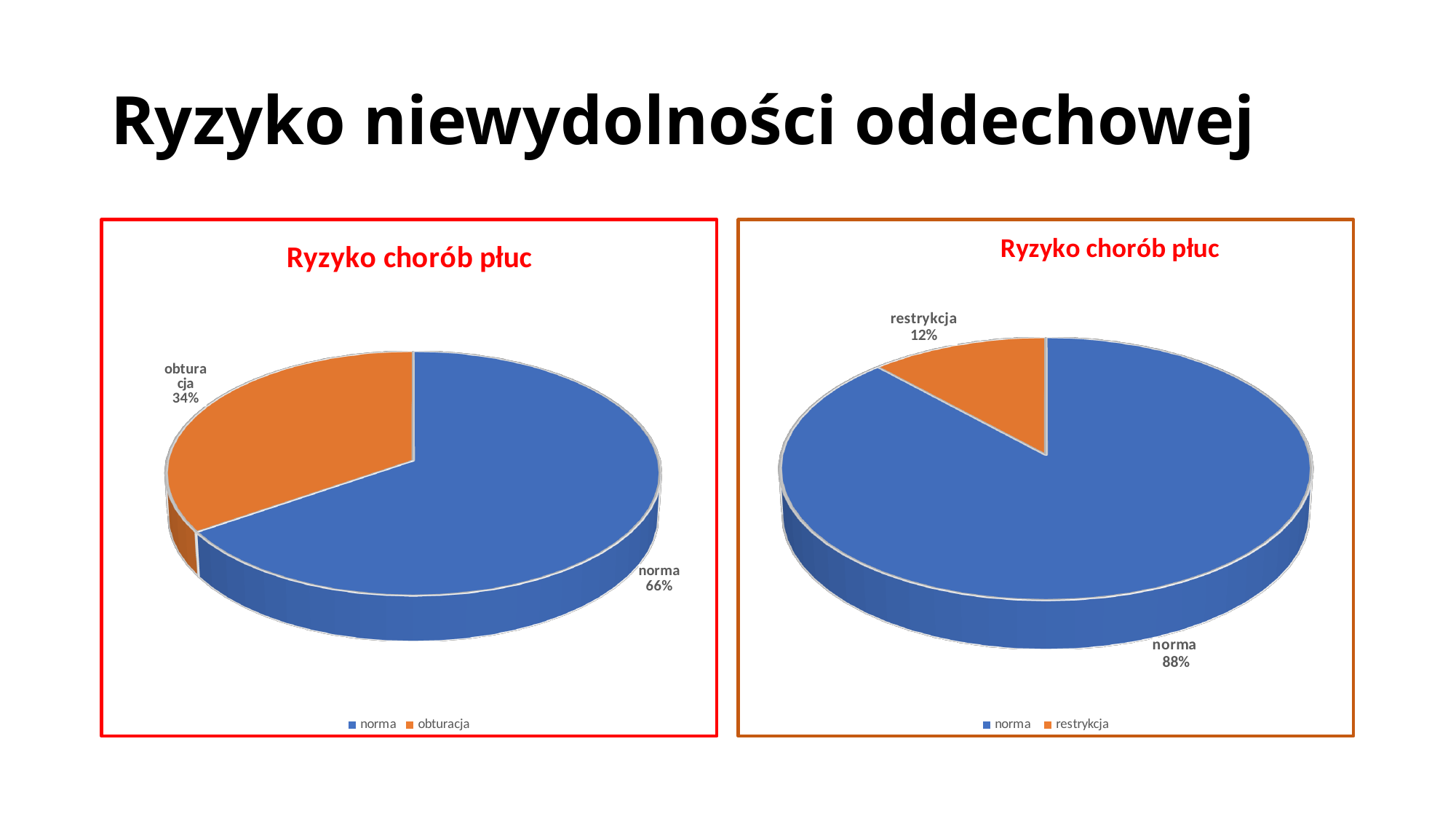
What entries does the legend of the right chart list? norma, restrykcja In the right pie chart, which slice is the smallest? restrykcja In the left pie chart, what share does the 'norma' slice have? 66% In the right pie chart, what is the difference in percentage points between 'norma' and 'restrykcja'? 76 In the right pie chart, what share does the 'norma' slice have? 88% In the left pie chart, what share does the 'obturacja' slice have? 34% In the left pie chart, which slice is the largest? norma What type of chart is shown on the right side of the slide? pie chart How many slices does the left pie chart have? 2 Which is larger: the 'norma' share in the left chart or the 'norma' share in the right chart? the right chart In the left pie chart, what is the difference in percentage points between 'norma' and 'obturacja'? 32